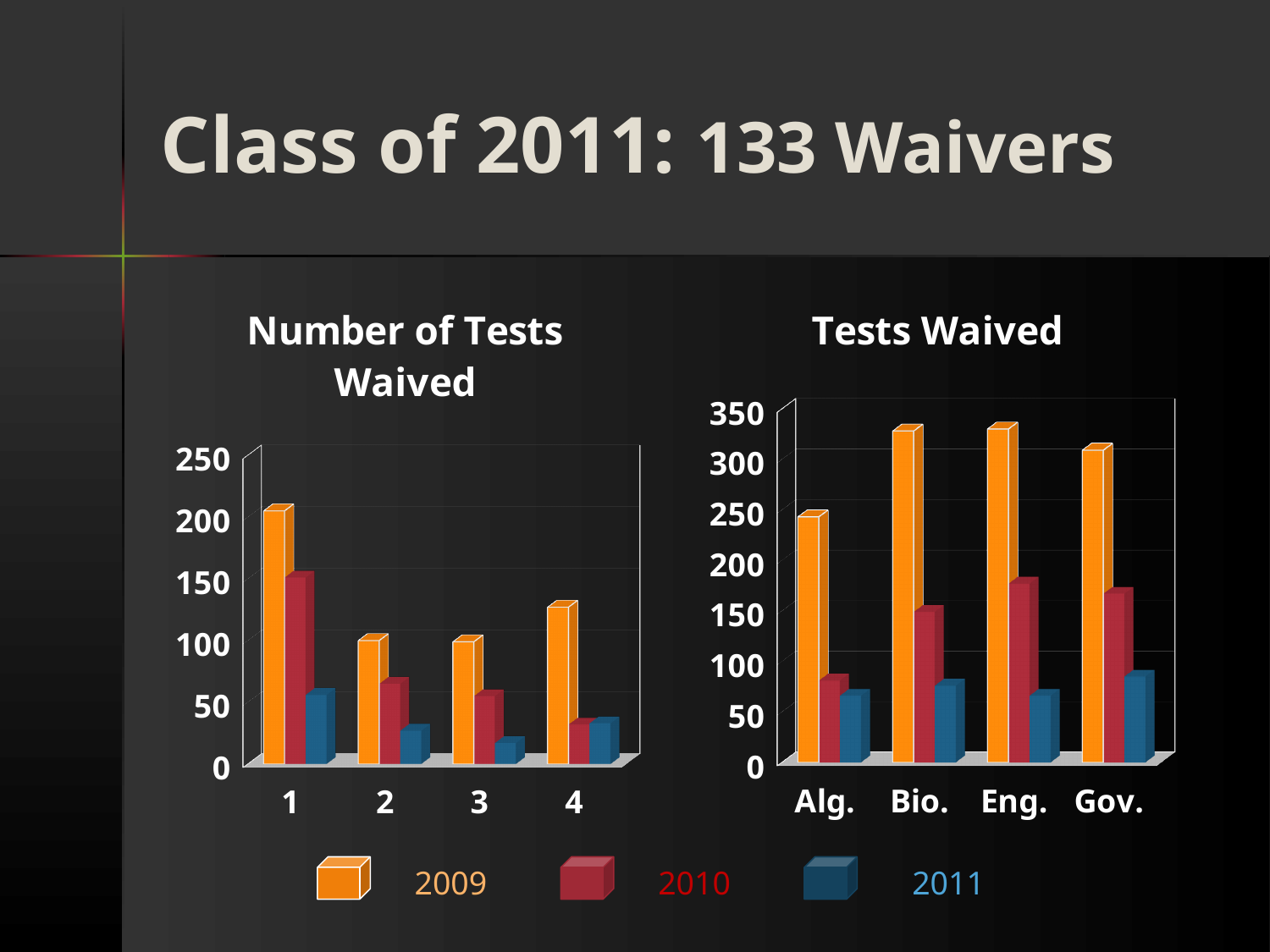
In the "Tests Waived" chart, is the 2009 value for Alg. greater or less than 200? greater In the "Tests Waived" chart on the right, which category has the lowest 2009 value? Alg. How many series does the legend list for the charts? 3 In the "Number of Tests Waived" chart, which category has the highest 2009 value? 1 In the "Number of Tests Waived" chart, is the 2009 value for category 1 greater or less than 150? greater In the "Number of Tests Waived" chart, is the 2011 value for category 3 greater or less than 50? less What kind of chart is the "Number of Tests Waived" chart on the left? bar chart How many categories are shown on the x axis of the "Number of Tests Waived" chart? 4 In the "Number of Tests Waived" chart, which series has the lowest value for category 2? 2011 In the "Tests Waived" chart, which is larger for Eng., the 2010 value or the 2011 value? 2010